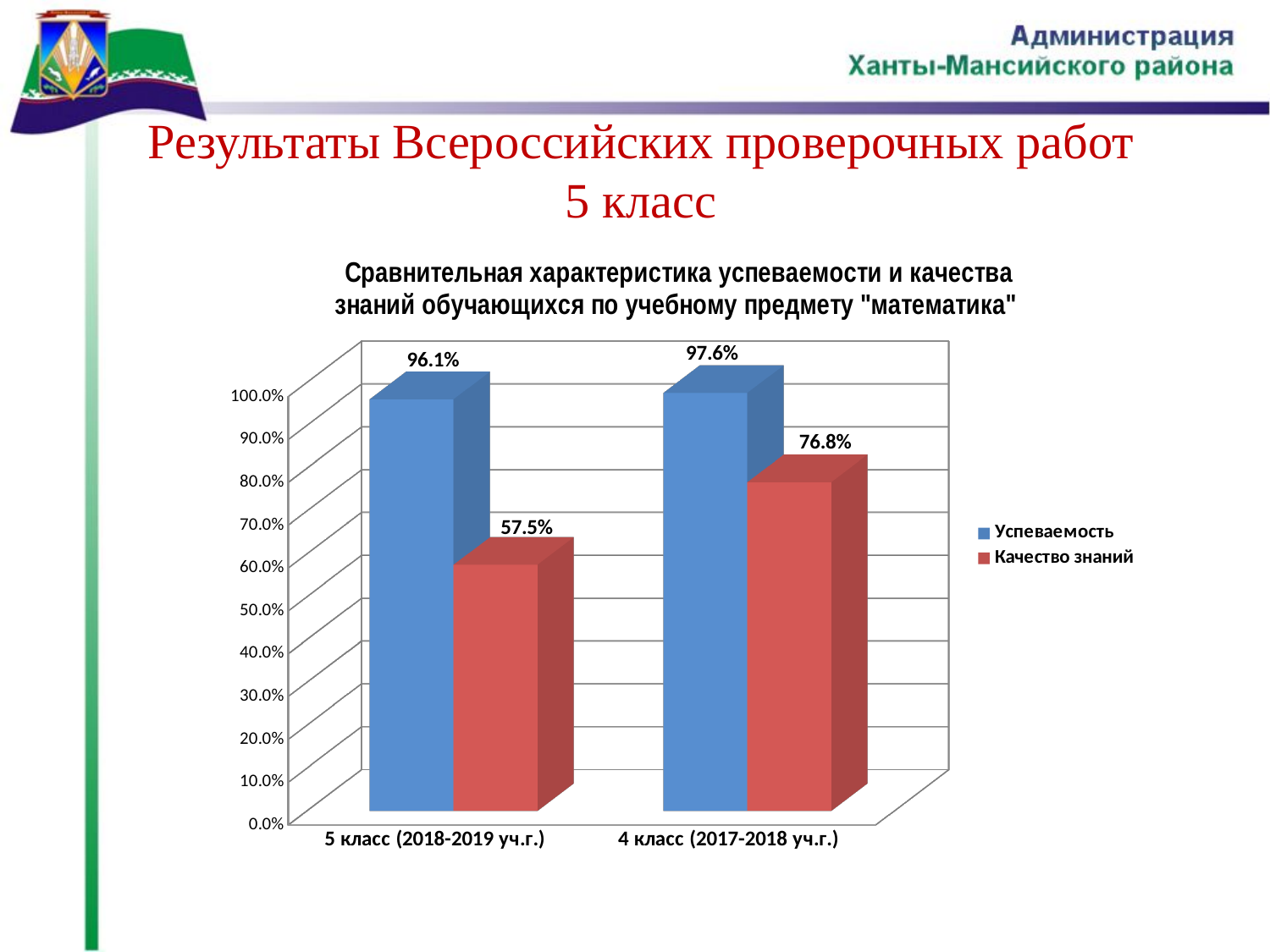
What kind of chart is shown on the slide? Bar chart What is the value of Качество знаний for 4 класс (2017-2018 уч.г.)? 76.8% Is the value of Качество знаний for 5 класс (2018-2019 уч.г.) greater or less than 60.0%? less Which category has the lowest Качество знаний value? 5 класс (2018-2019 уч.г.) What is the difference between Качество знаний for 4 класс (2017-2018 уч.г.) and 5 класс (2018-2019 уч.г.)? 19.3% How many series does the legend list? 2 What is the difference between Успеваемость and Качество знаний for 5 класс (2018-2019 уч.г.)? 38.6% What is the value of Успеваемость for 5 класс (2018-2019 уч.г.)? 96.1% What is the value of Качество знаний for 5 класс (2018-2019 уч.г.)? 57.5% How many categories are shown on the x axis? 2 Which is larger: Качество знаний for 5 класс (2018-2019 уч.г.) or Качество знаний for 4 класс (2017-2018 уч.г.)? 4 класс (2017-2018 уч.г.) Which category has the higher Успеваемость value? 4 класс (2017-2018 уч.г.)